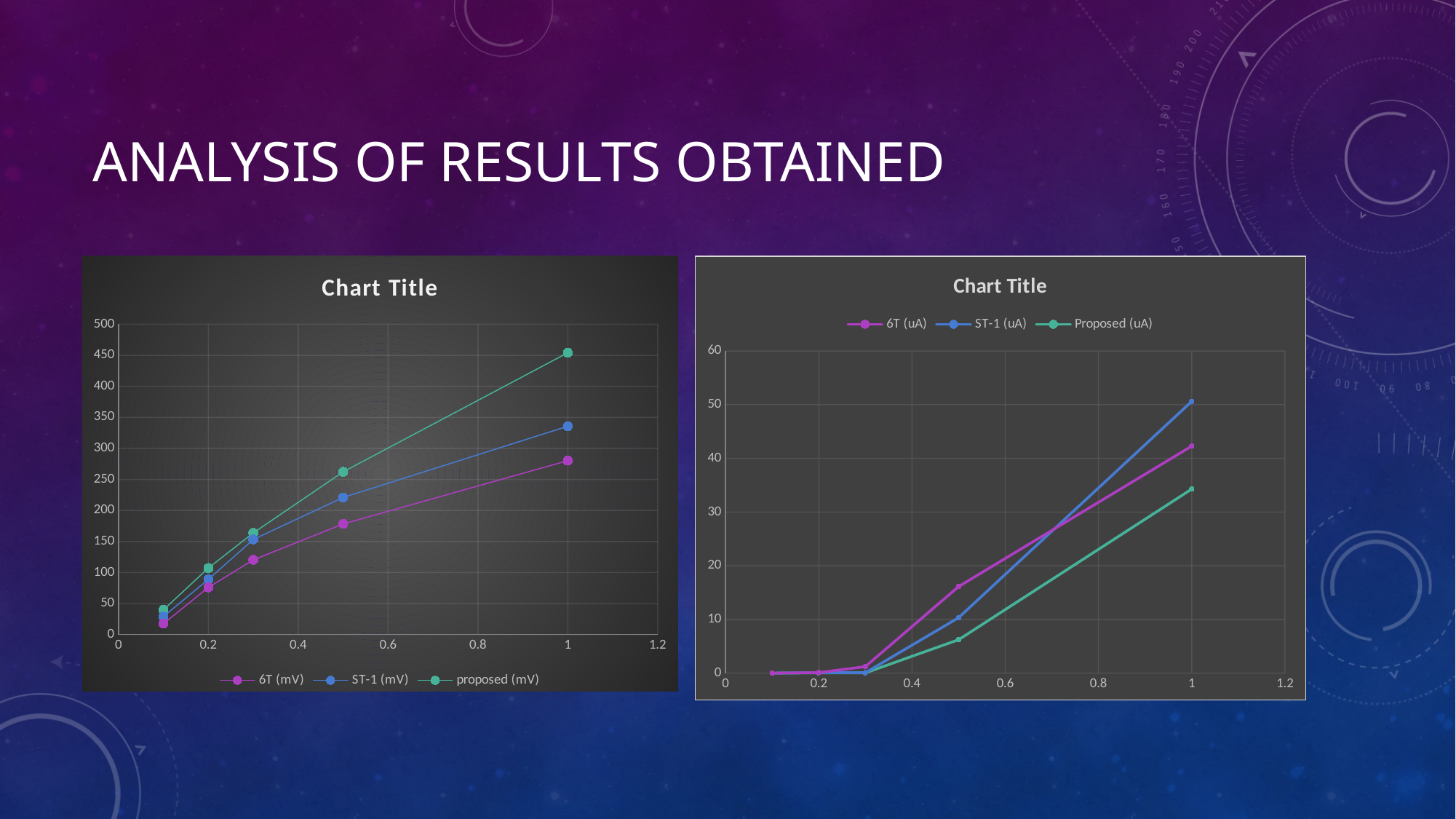
What kind of chart is the left chart on the slide? line chart In the left chart, which series has the lowest value at x = 1? 6T (mV) In the left chart, is the value of proposed (mV) at x = 1 greater or less than 400? greater In the left chart, which series has the highest value at x = 1? proposed (mV) How many series does the legend of the left chart list? 3 In the left chart, do the values of proposed (mV) rise or fall as x increases? rise In the right chart, which series has the lowest value at x = 1? Proposed (uA) In the right chart, at x = 0.5, which is larger: 6T (uA) or Proposed (uA)? 6T (uA) How many series does the legend of the right chart list? 3 In the left chart, is the value of 6T (mV) at x = 1 greater or less than 300? less In the right chart, which series has the highest value at x = 1? ST-1 (uA)